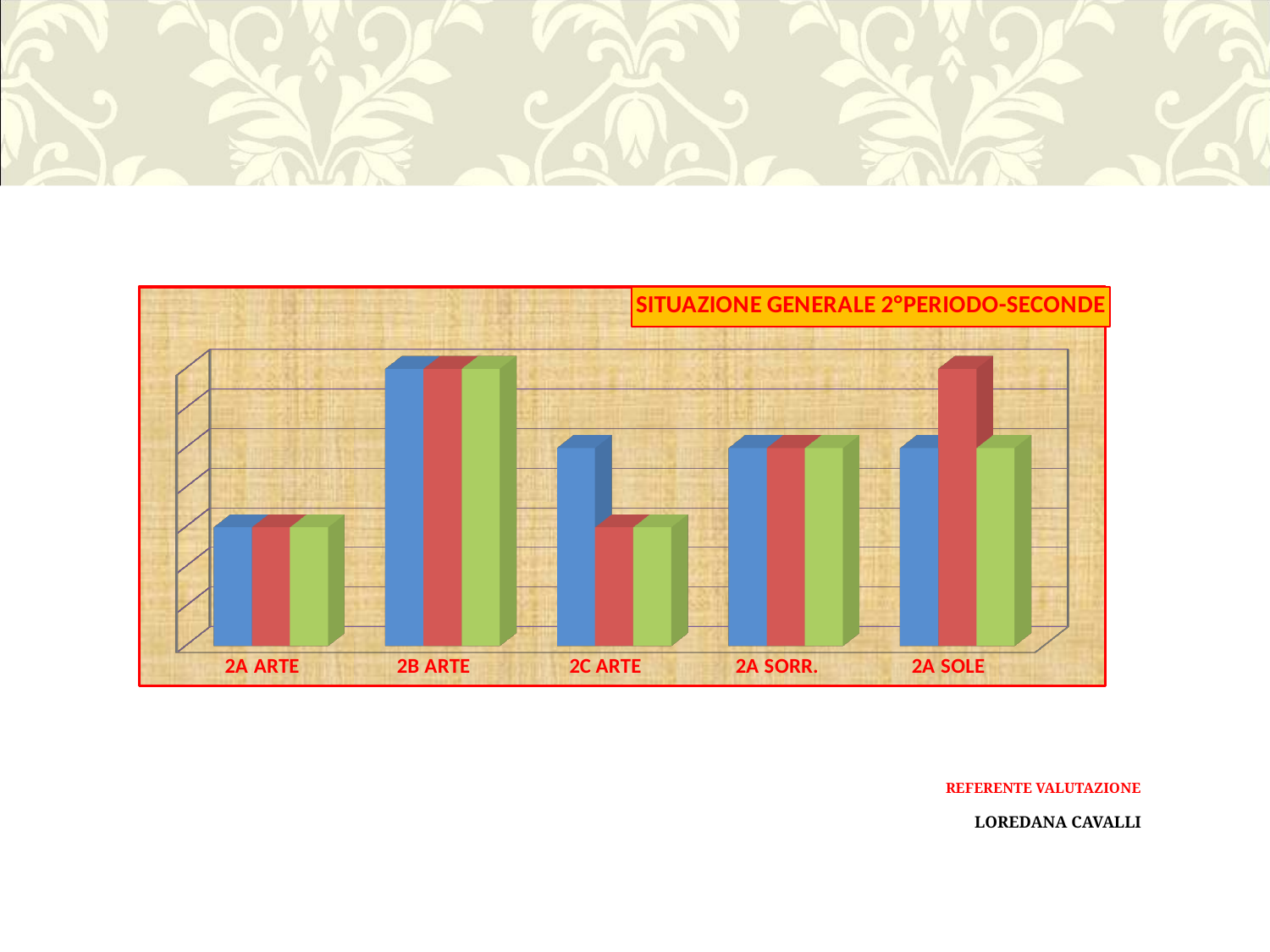
Which category has the tallest bars in the chart? 2B ARTE What three colours are used for the bars in the chart? Blue, red and green How many categories are shown on the x axis of the chart? 5 What kind of chart is shown on the slide? Bar chart Which category has the shortest bars in the chart? 2A ARTE Is the blue bar for 2B ARTE taller or shorter than the blue bar for 2A ARTE? Taller For 2C ARTE, is the blue bar taller or shorter than the red bar? Taller Is the red bar for 2A SOLE taller or shorter than the red bar for 2A SORR.? Taller How many bars are plotted for each category in the chart? 3 What is the title of the chart? SITUAZIONE GENERALE 2°PERIODO-SECONDE